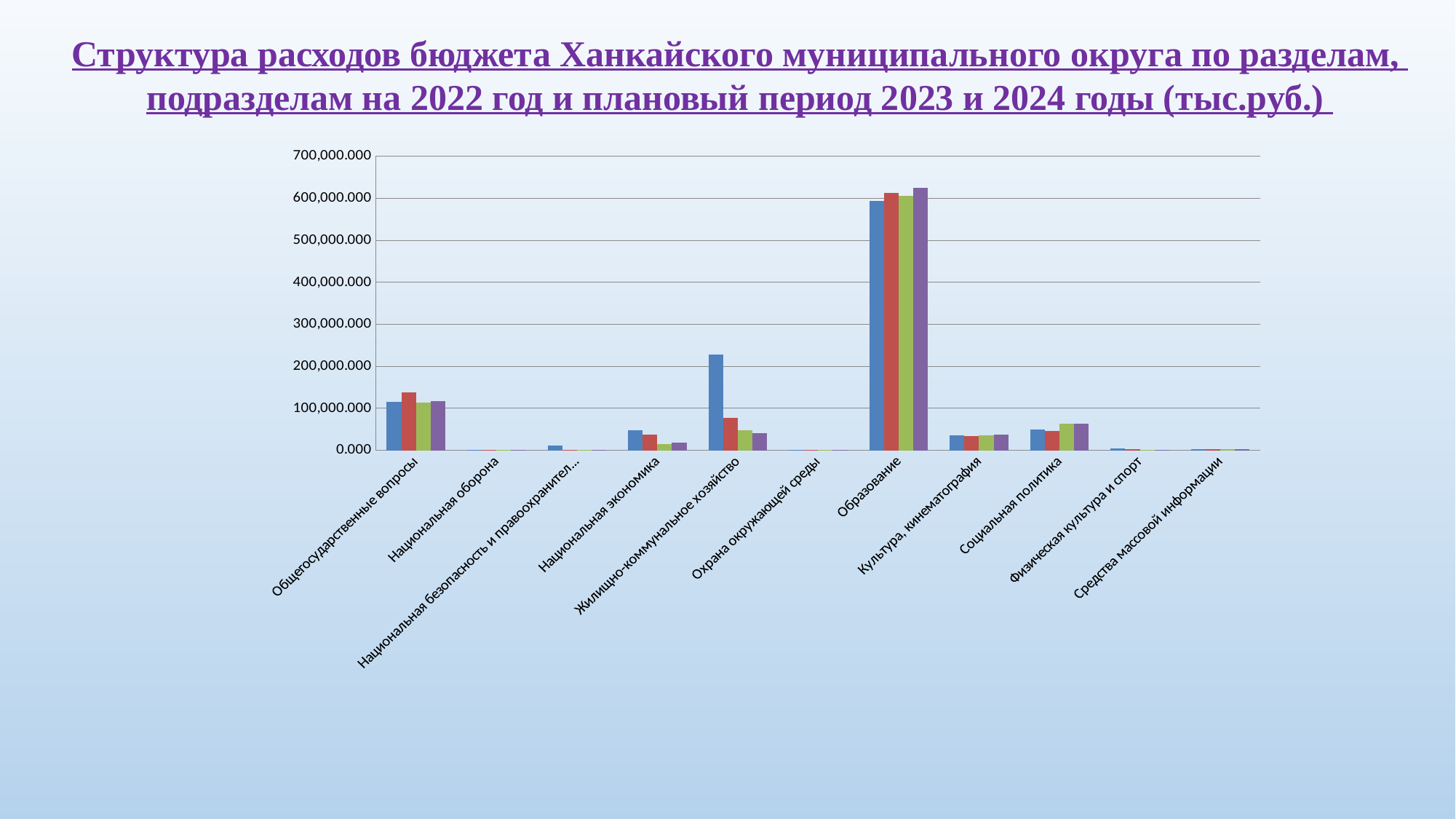
What unit is given in the slide title for the values in the chart? тыс.руб. Within the Жилищно-коммунальное хозяйство category, which is larger: the first (blue) bar or the second (red) bar? the first (blue) bar Is the value of the first (blue) bar for Образование greater or less than 500,000.000? greater How many categories are shown along the x axis of the chart? 11 Is the value of the first (blue) bar for Общегосударственные вопросы greater or less than 100,000.000? greater How many bars are plotted for each category in the chart? 4 Is the value of the first (blue) bar for Социальная политика greater or less than 100,000.000? less What kind of chart is shown on the slide? bar chart Which is larger: the first (blue) bar for Образование or the first (blue) bar for Жилищно-коммунальное хозяйство? Образование Which category has the highest bars in the chart? Образование What is the highest value shown on the vertical axis of the chart? 700,000.000